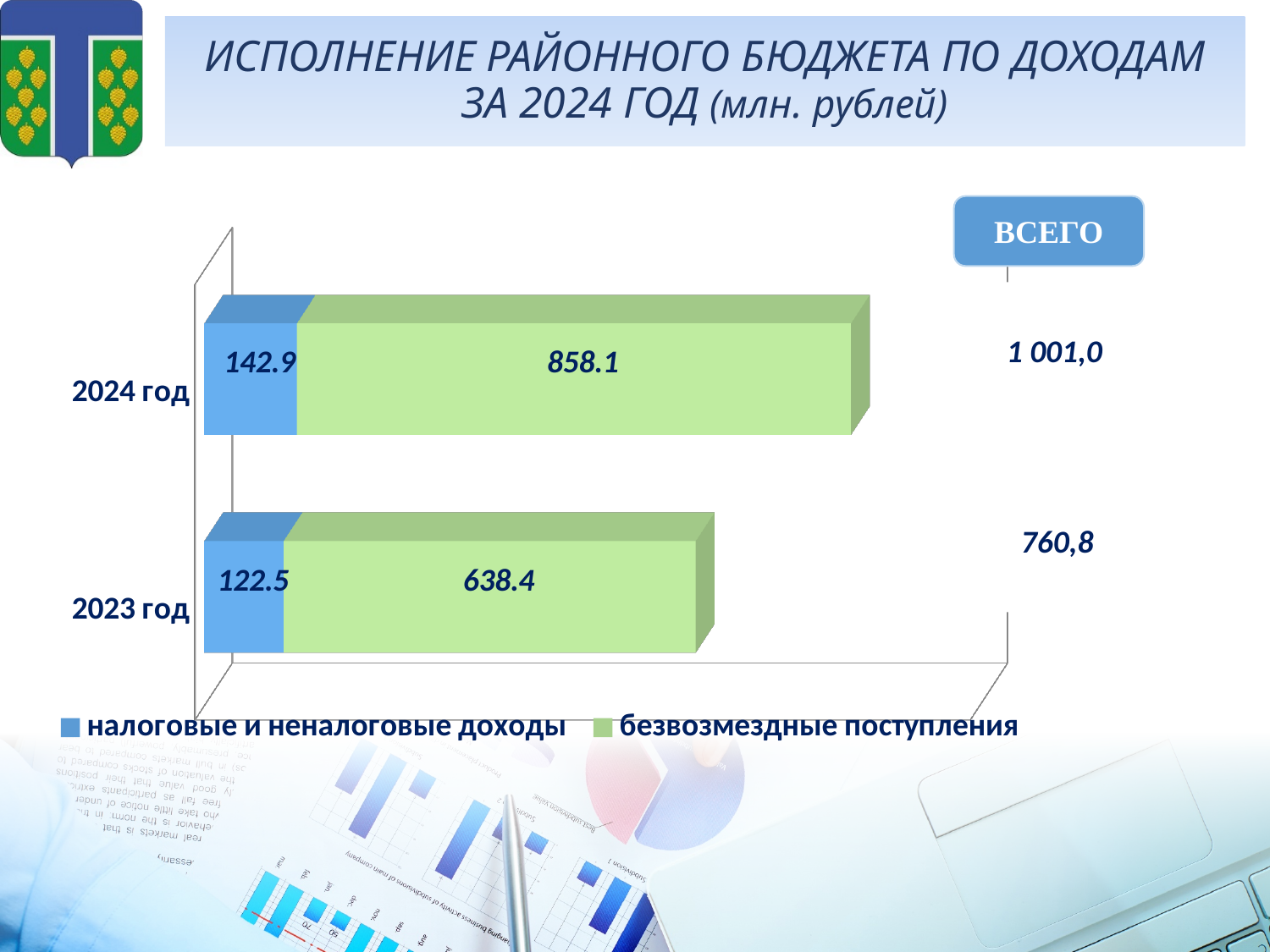
Is the value of налоговые и неналоговые доходы larger in 2024 год or 2023 год? 2024 год What is the total (ВСЕГО) shown for 2023 год? 760,8 What is the difference between безвозмездные поступления in 2024 год and 2023 год? 219.7 What is the value of безвозмездные поступления for 2023 год? 638.4 How many series does the legend list? 2 What is the total (ВСЕГО) shown for 2024 год? 1 001,0 Which year has the lower value for налоговые и неналоговые доходы? 2023 год What is the value of безвозмездные поступления for 2024 год? 858.1 Which year has the higher value for безвозмездные поступления? 2024 год What kind of chart is shown on the slide? Stacked bar chart What is the value of налоговые и неналоговые доходы for 2023 год? 122.5 What is the value of налоговые и неналоговые доходы for 2024 год? 142.9